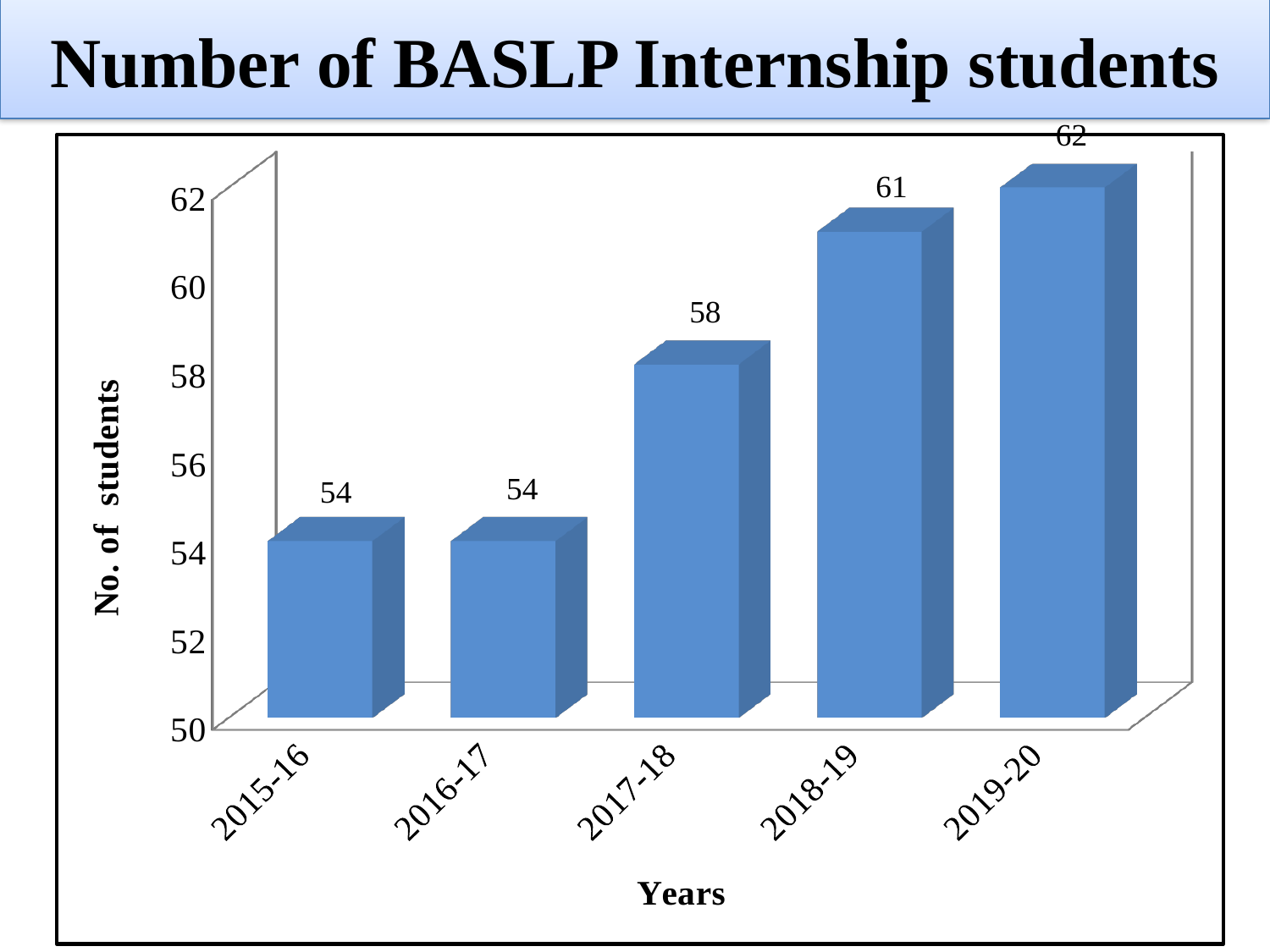
How many years are shown on the chart? 5 What is the label of the vertical axis? No. of students Do the values rise or fall from 2015-16 to 2019-20? rise What is the number of students for 2018-19? 61 Which is larger, the number of students in 2017-18 or in 2016-17? 2017-18 What kind of chart is shown on the slide? bar chart What is the difference in the number of students between 2019-20 and 2015-16? 8 How many BASLP internship students were there in 2017-18? 58 Which year has the highest number of students? 2019-20 What is the number of students for 2015-16? 54 Is the value for 2018-19 greater or less than 60? greater What is the difference in the number of students between 2018-19 and 2017-18? 3